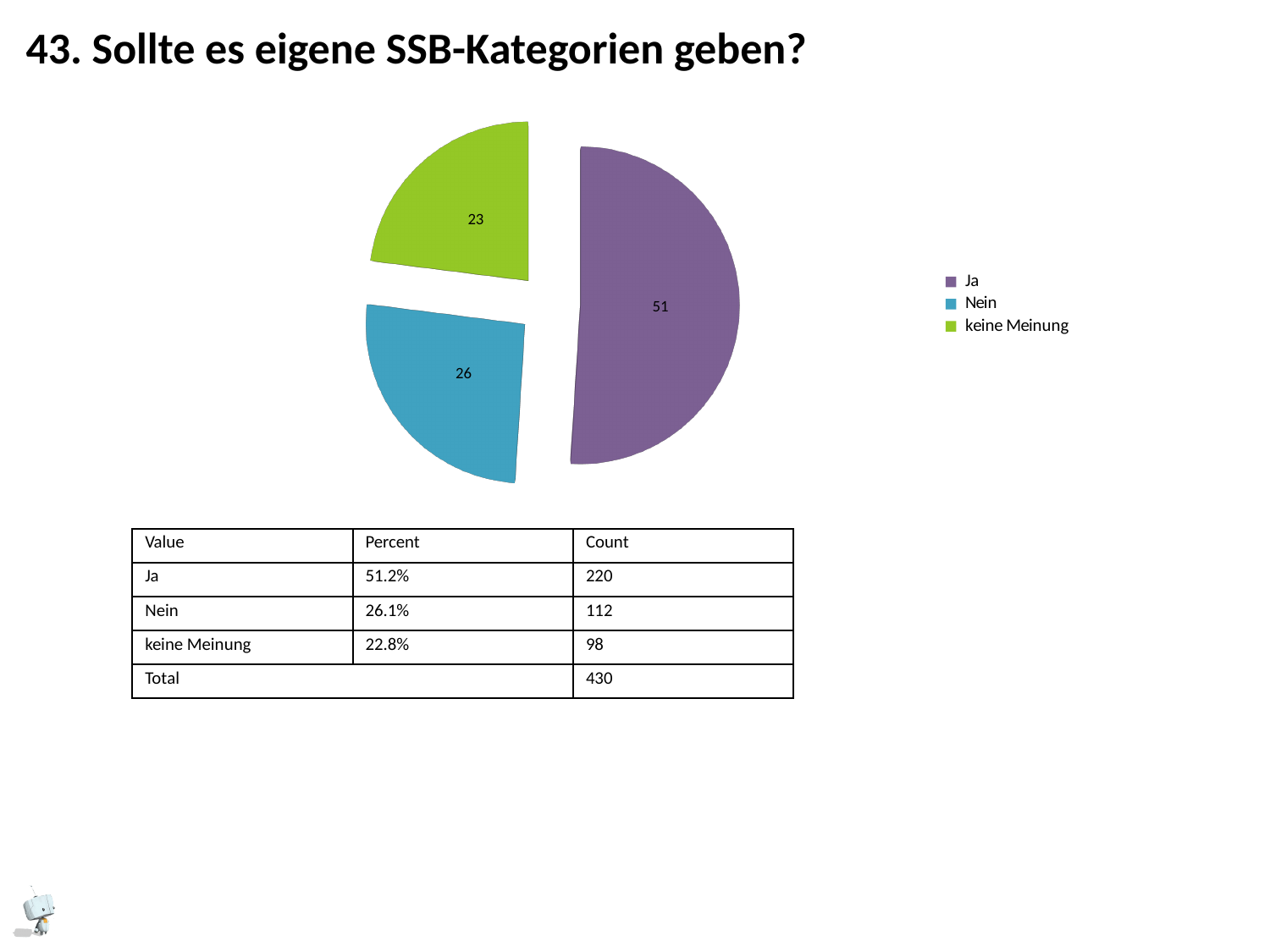
Which category has the smallest slice of the pie? keine Meinung How many entries does the legend list? 3 What is the title of the slide containing the pie chart? 43. Sollte es eigene SSB-Kategorien geben? Which category has the largest slice of the pie? Ja What colour is the Ja slice in the pie chart? purple What value is printed on the pie slice for keine Meinung? 23 Which slice is larger, Nein or keine Meinung? Nein What value is printed on the pie slice for Nein? 26 How many slices does the pie chart have? 3 What is the difference between the values printed on the Ja slice and the Nein slice? 25 What value is printed on the pie slice for Ja? 51 What kind of chart is shown on the slide? pie chart